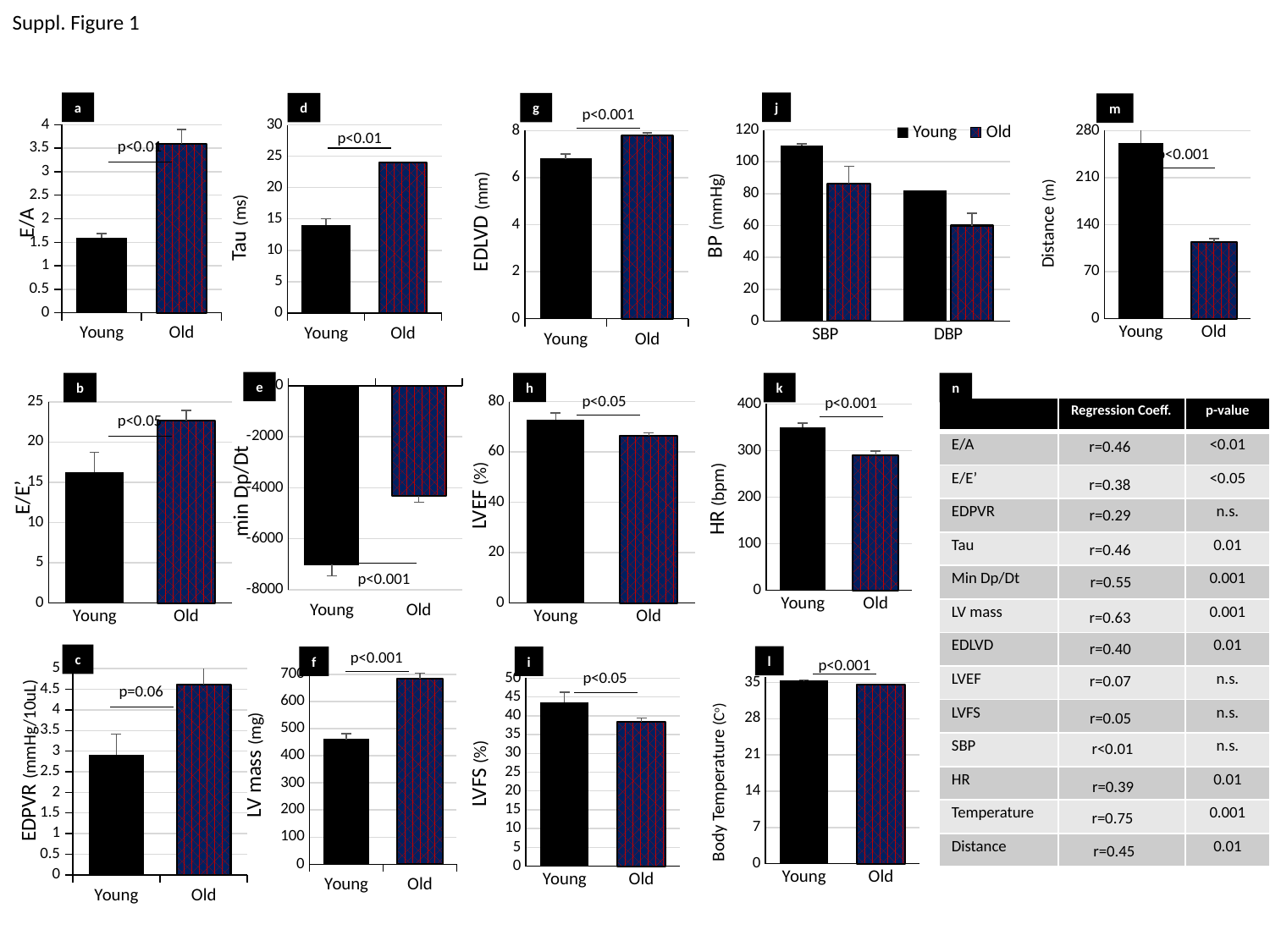
In chart a (E/A), is the value for Old greater or less than 3? greater What p-value is printed on chart c (EDPVR)? p=0.06 In chart j (BP), is the SBP value for Young greater or less than 100? greater In chart i (LVFS), is the value for Young greater or less than 40? greater What kind of chart is chart h (LVEF)? bar chart In chart d (Tau), which group has the higher value, Young or Old? Old In chart j (BP), which is larger, the DBP value for Young or the DBP value for Old? Young In chart k (HR), which group has the lower value, Young or Old? Old In chart j (BP), how many series does the legend list? 2